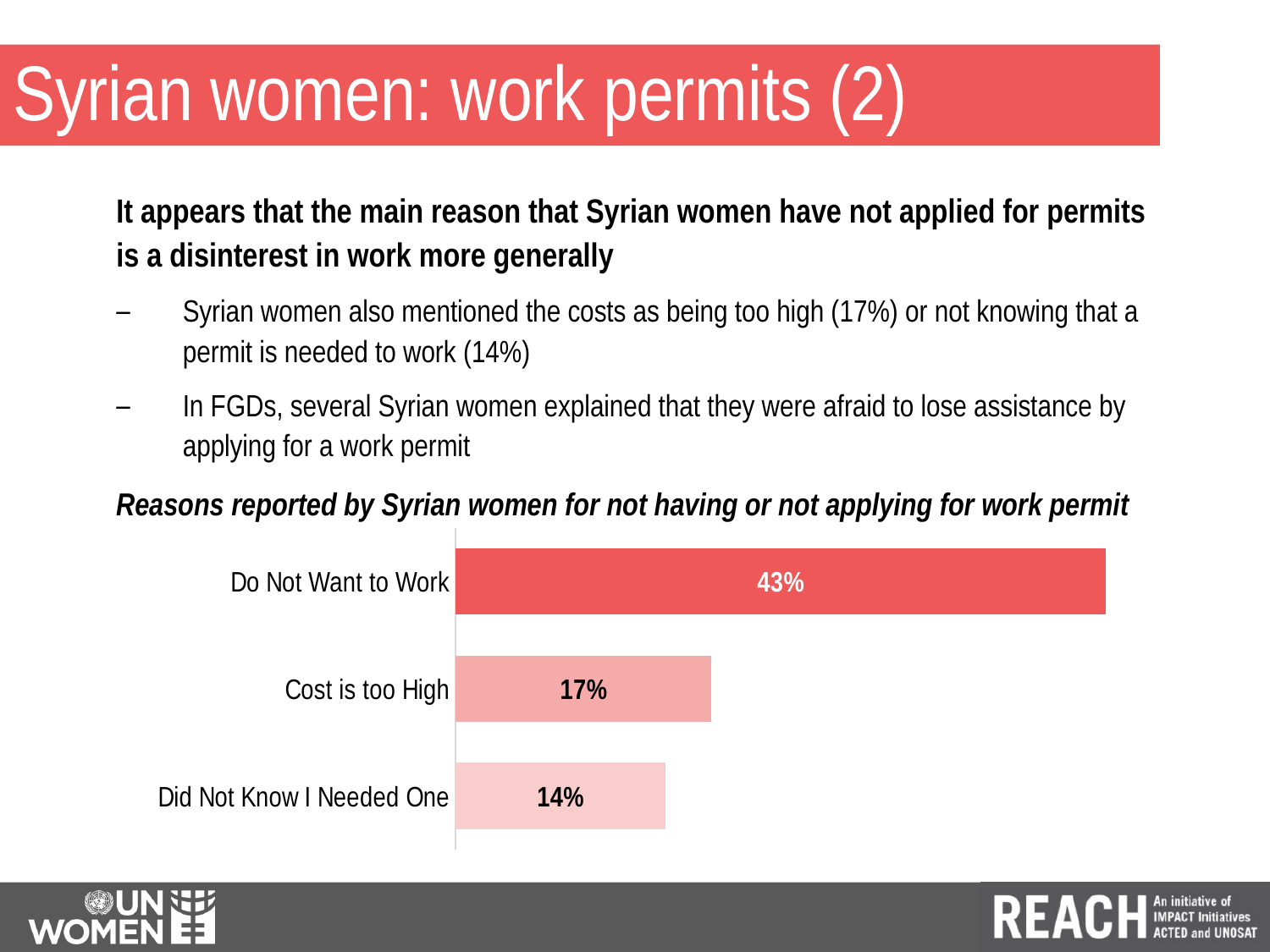
What is the difference in percentage points between "Do Not Want to Work" and "Cost is too High"? 26 percentage points Which is larger: the value for "Cost is too High" or the value for "Did Not Know I Needed One"? Cost is too High What type of chart is used on the slide? Bar chart What is the title of the chart? Reasons reported by Syrian women for not having or not applying for work permit What is the difference in percentage points between "Cost is too High" and "Did Not Know I Needed One"? 3 percentage points Which reason has the highest percentage in the chart? Do Not Want to Work Which reason has the lowest percentage in the chart? Did Not Know I Needed One What percentage of Syrian women reported "Do Not Want to Work" as a reason for not having or applying for a work permit? 43% What value is shown for "Did Not Know I Needed One"? 14% What value is shown for "Cost is too High"? 17% Which bar in the chart is the darkest shade of red? Do Not Want to Work How many reasons (categories) are shown in the chart? 3